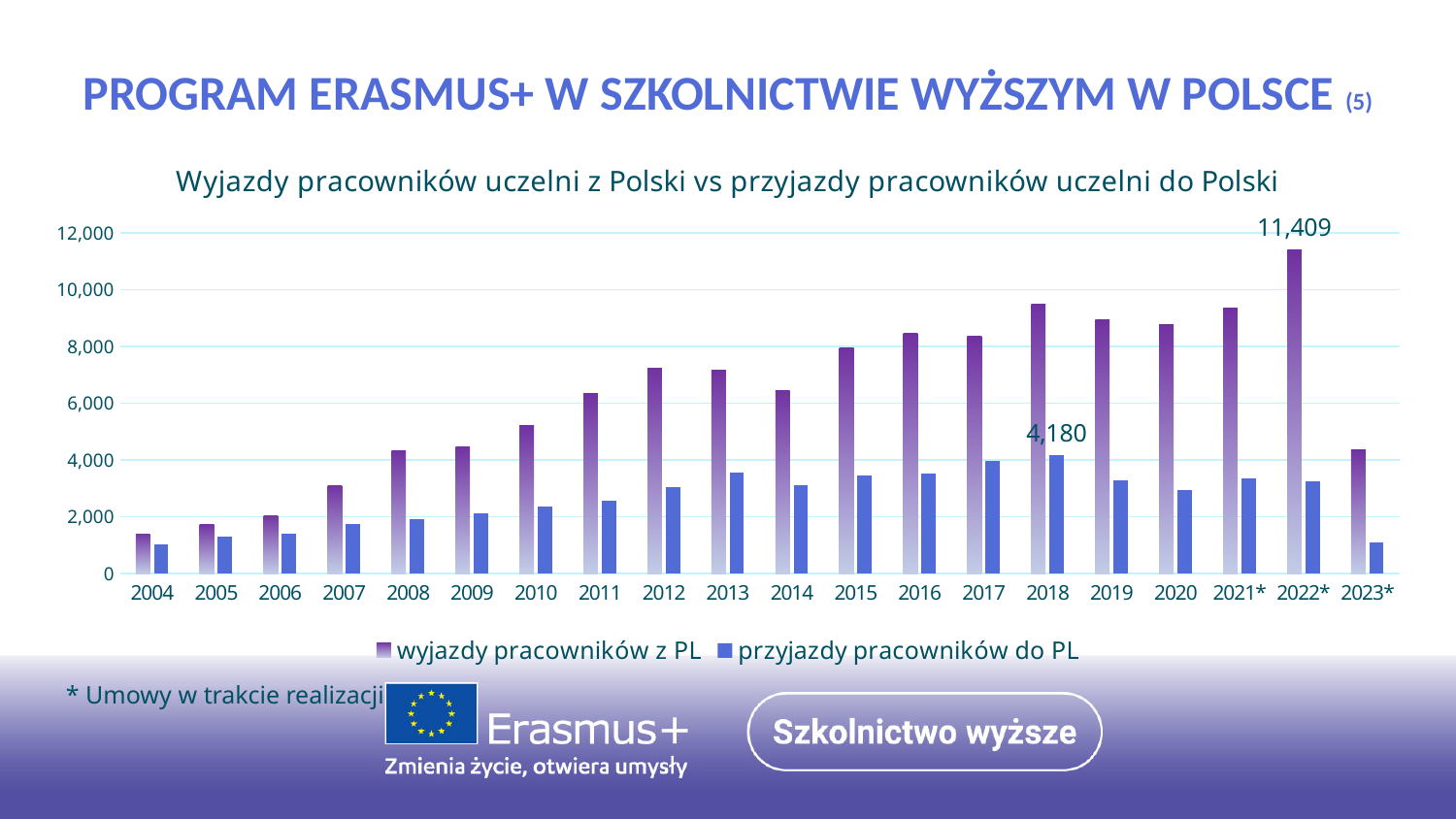
How many years are shown on the x axis of the chart? 20 What is the value for przyjazdy pracowników do PL in 2018? 4,180 In which year is the value for wyjazdy pracowników z PL the lowest? 2004 Is the value for przyjazdy pracowników do PL in 2023* greater or less than 2,000? less In 2022*, which is larger: wyjazdy pracowników z PL or przyjazdy pracowników do PL? wyjazdy pracowników z PL Is the value for wyjazdy pracowników z PL in 2010 greater or less than 6,000? less In which year is the value for przyjazdy pracowników do PL the highest? 2018 In which year is the value for wyjazdy pracowników z PL the highest? 2022* What is the value for wyjazdy pracowników z PL in 2022*? 11,409 How many series does the legend list? 2 Do the values for wyjazdy pracowników z PL rise or fall from 2004 to 2012? rise What kind of chart is shown on the slide? bar chart